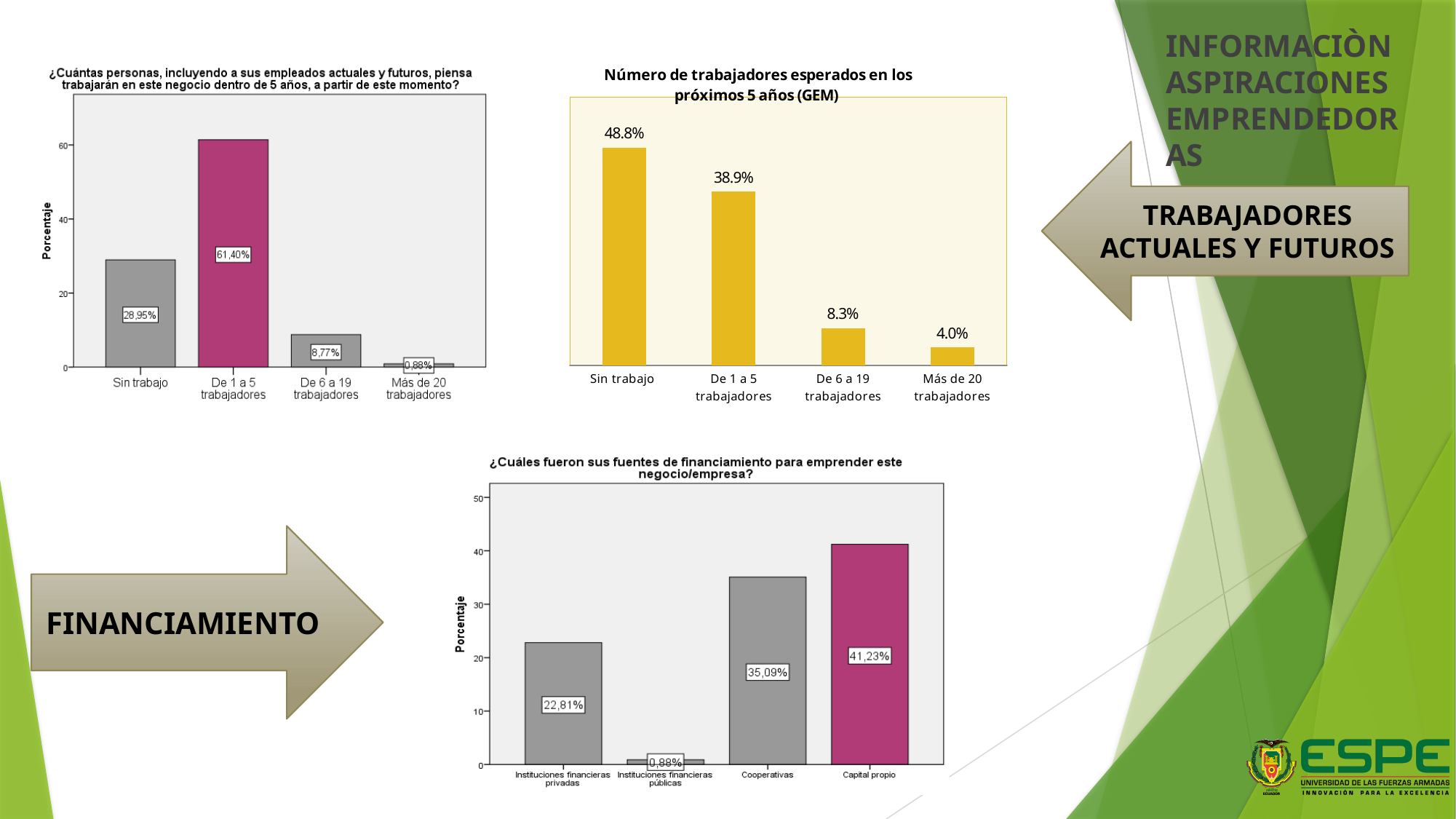
In the top-left chart (¿Cuántas personas... piensa trabajarán en este negocio dentro de 5 años?), what is the difference between 'De 1 a 5 trabajadores' and 'Sin trabajo'? 32,45% In the chart titled 'Número de trabajadores esperados en los próximos 5 años (GEM)', do the values rise or fall from left to right? fall In the chart titled 'Número de trabajadores esperados en los próximos 5 años (GEM)', which category has the highest value? Sin trabajo In the bottom chart (¿Cuáles fueron sus fuentes de financiamiento...?), what is the value for 'Cooperativas'? 35,09% In the chart titled 'Número de trabajadores esperados en los próximos 5 años (GEM)', how many categories are shown? 4 What type of chart is the bottom chart (¿Cuáles fueron sus fuentes de financiamiento...?)? bar chart In the chart titled 'Número de trabajadores esperados en los próximos 5 años (GEM)', what is the value for 'Sin trabajo'? 48.8% In the bottom chart (¿Cuáles fueron sus fuentes de financiamiento...?), what is the difference between 'Capital propio' and 'Instituciones financieras públicas'? 40,35% In the top-left chart (¿Cuántas personas... piensa trabajarán en este negocio dentro de 5 años?), which category has the lowest value? Más de 20 trabajadores In the bottom chart (¿Cuáles fueron sus fuentes de financiamiento...?), which category has the highest value? Capital propio In the bottom chart (¿Cuáles fueron sus fuentes de financiamiento...?), which is larger: 'Instituciones financieras privadas' or 'Cooperativas'? Cooperativas In the top-left chart (¿Cuántas personas... piensa trabajarán en este negocio dentro de 5 años?), what is the value for 'De 1 a 5 trabajadores'? 61,40%